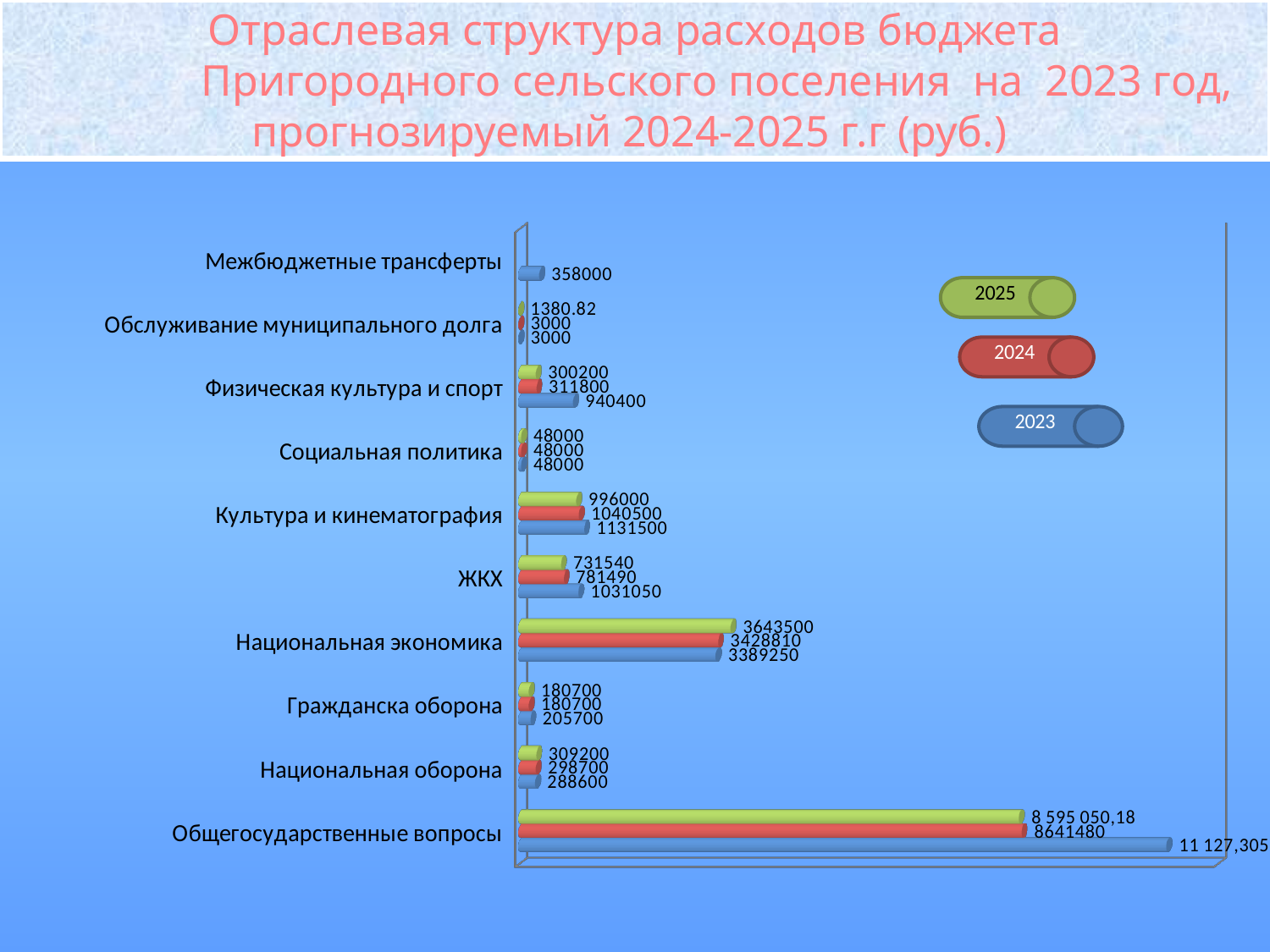
Which category has the highest value for 2023? Общегосударственные вопросы What kind of chart is shown on the slide? bar chart Which category has the lowest value for 2024? Обслуживание муниципального долга How many series does the legend list? 3 Which colour represents the 2024 series in the legend? red Which is larger for Национальная оборона: the 2025 value or the 2023 value? 2025 What is the difference between the 2023 and 2024 values for Физическая культура и спорт? 628600 How many categories are shown on the chart? 10 What is the value for ЖКХ in 2024? 781490 What is the value for Культура и кинематография in 2023? 1131500 What is the value for Национальная экономика in 2025? 3643500 What is the value for Межбюджетные трансферты in 2023? 358000